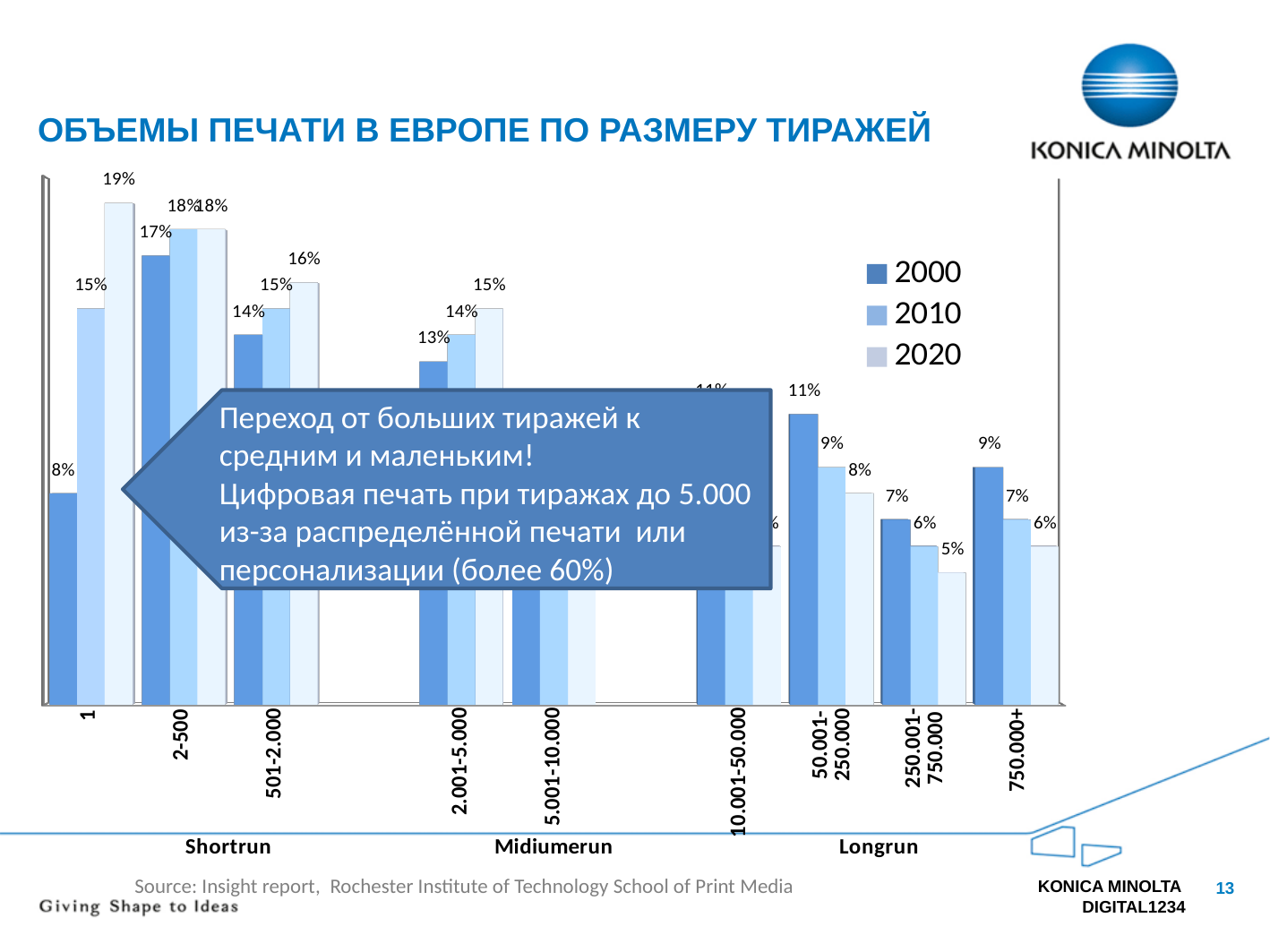
What kind of chart is shown on the slide? Bar chart What is the value for the 2020 series in the '1' category? 19% What is the value for the 2000 series in the '750.000+' category? 9% How many series does the legend list? 3 Among the Longrun categories, which has the lowest value for the 2020 series? 250.001-750.000 Which category has the highest value for the 2020 series? 1 What is the value for the 2020 series in the '250.001-750.000' category? 5% What is the value for the 2000 series in the '2-500' category? 17% What is the difference between the 2020 and 2000 values in the '1' category? 11% In the '50.001-250.000' category, which series has the larger value, 2000 or 2020? 2000 What is the value for the 2010 series in the '501-2.000' category? 15% In the '750.000+' category, do the values rise or fall from 2000 to 2020? Fall